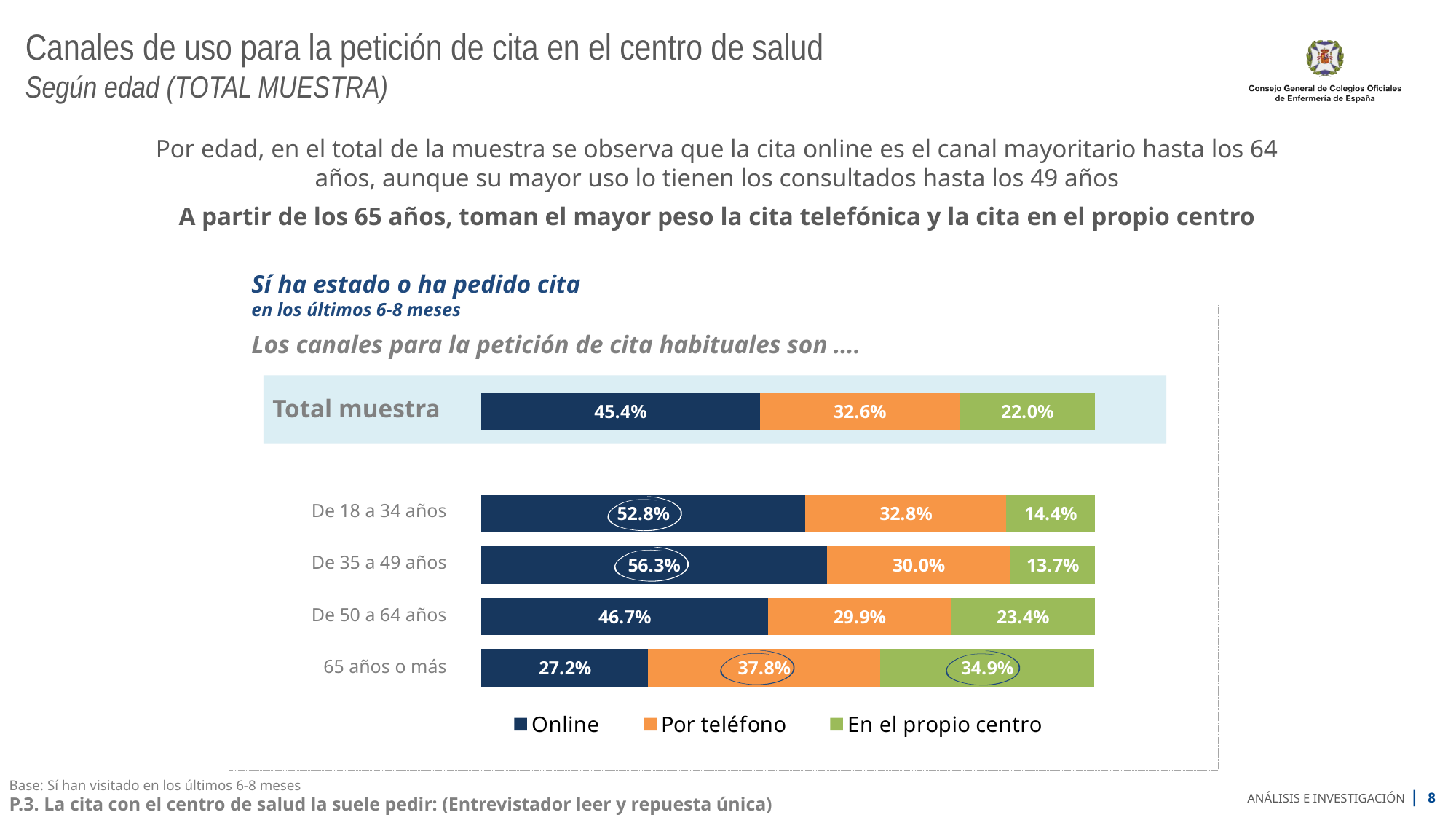
What is the 'En el propio centro' value for 'Total muestra'? 22.0% What is the total of the stacked bar for 'De 18 a 34 años'? 100.0% How many age groups (excluding 'Total muestra') are shown in the chart? 4 What is the Online value for the 'De 35 a 49 años' group? 56.3% Which legend entry is shown in orange? Por teléfono Which age group has the highest Online value? De 35 a 49 años What is the 'Por teléfono' value for the '65 años o más' group? 37.8% Which age group has the lowest 'En el propio centro' value? De 35 a 49 años How many series does the legend list? 3 What type of chart is shown on the slide? Stacked bar chart What is the difference between the Online values for 'De 35 a 49 años' and 'De 18 a 34 años'? 3.5 percentage points Which is larger for the '65 años o más' group: 'Por teléfono' or 'En el propio centro'? Por teléfono